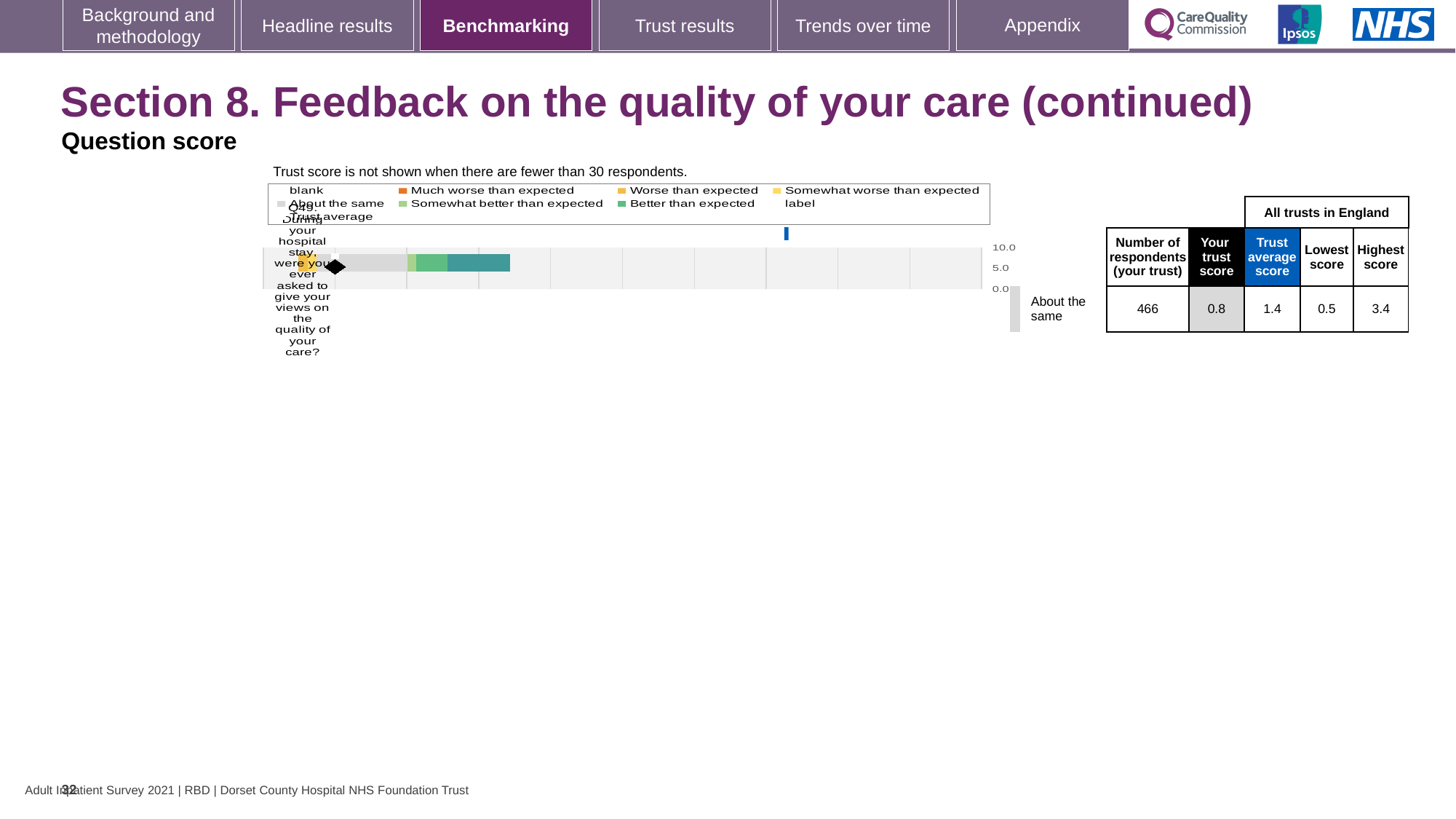
In the table beside the chart, what is your trust score for Q49? 0.8 In the table beside the chart, what is the lowest score among all trusts in England for Q49? 0.5 How many questions (categories) are plotted in the chart? 1 What kind of chart is shown on the slide? bar chart Which question number is plotted in the chart? Q49 What benchmark label is shown to the right of the chart for Q49? About the same By how much does the trust average score exceed your trust score for Q49? 0.6 What is the difference between the highest score and the lowest score for Q49? 2.9 In the table beside the chart, how many respondents from your trust answered Q49? 466 Which is larger for Q49: your trust score or the trust average score? Trust average score In the table beside the chart, what is the trust average score for Q49? 1.4 In the table beside the chart, what is the highest score among all trusts in England for Q49? 3.4